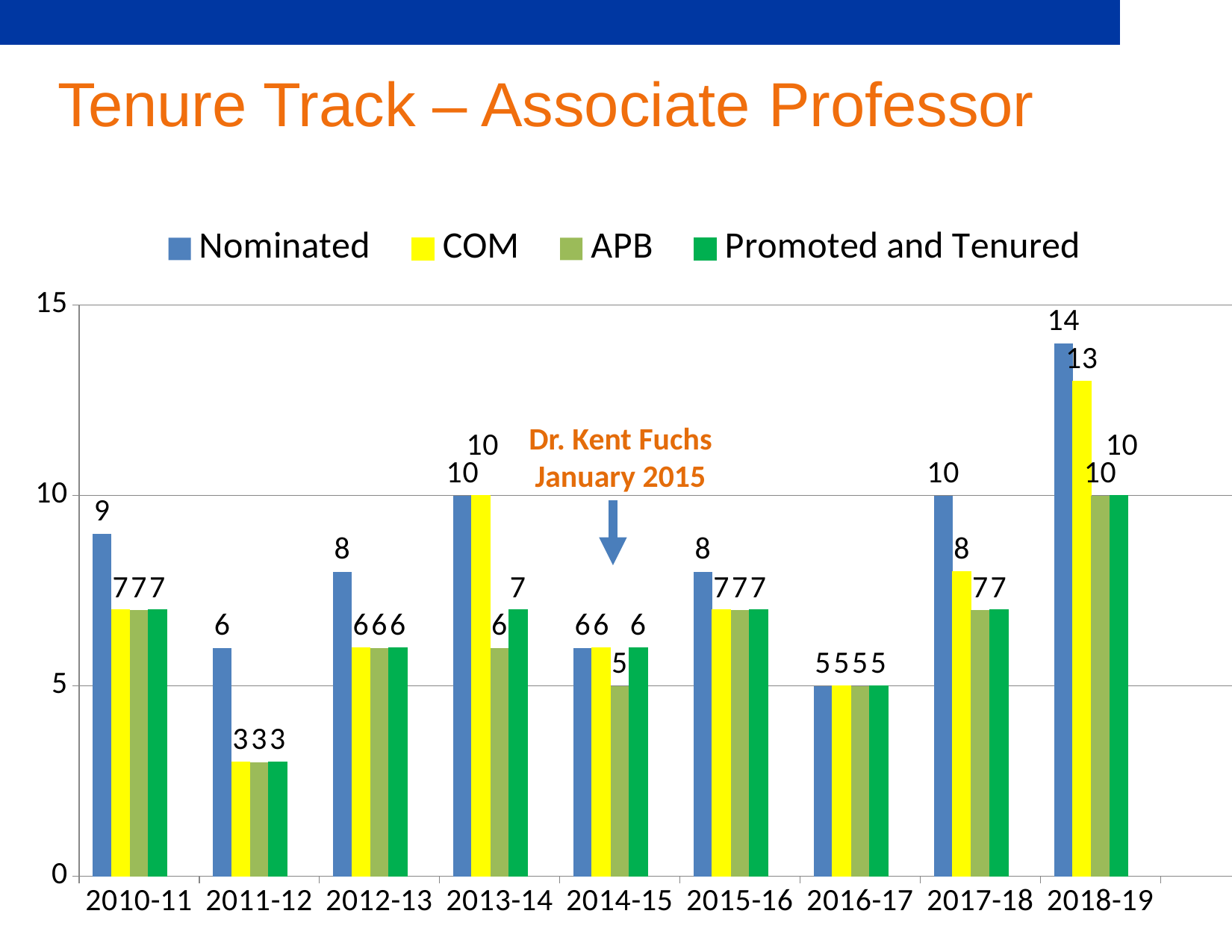
How many series does the legend list? 4 What is the difference between the Nominated and Promoted and Tenured values in 2018-19? 4 What is the Promoted and Tenured value for 2017-18? 7 How many academic years are shown on the x axis? 9 What kind of chart is shown on the slide? Bar chart What is the title of the slide containing the chart? Tenure Track – Associate Professor What is the Nominated value for 2018-19? 14 What is the COM value for 2011-12? 3 Which is larger in 2017-18, the COM value or the APB value? COM Which year has the lowest Promoted and Tenured value? 2011-12 Which year has the highest Nominated value? 2018-19 What is the APB value for 2013-14? 6